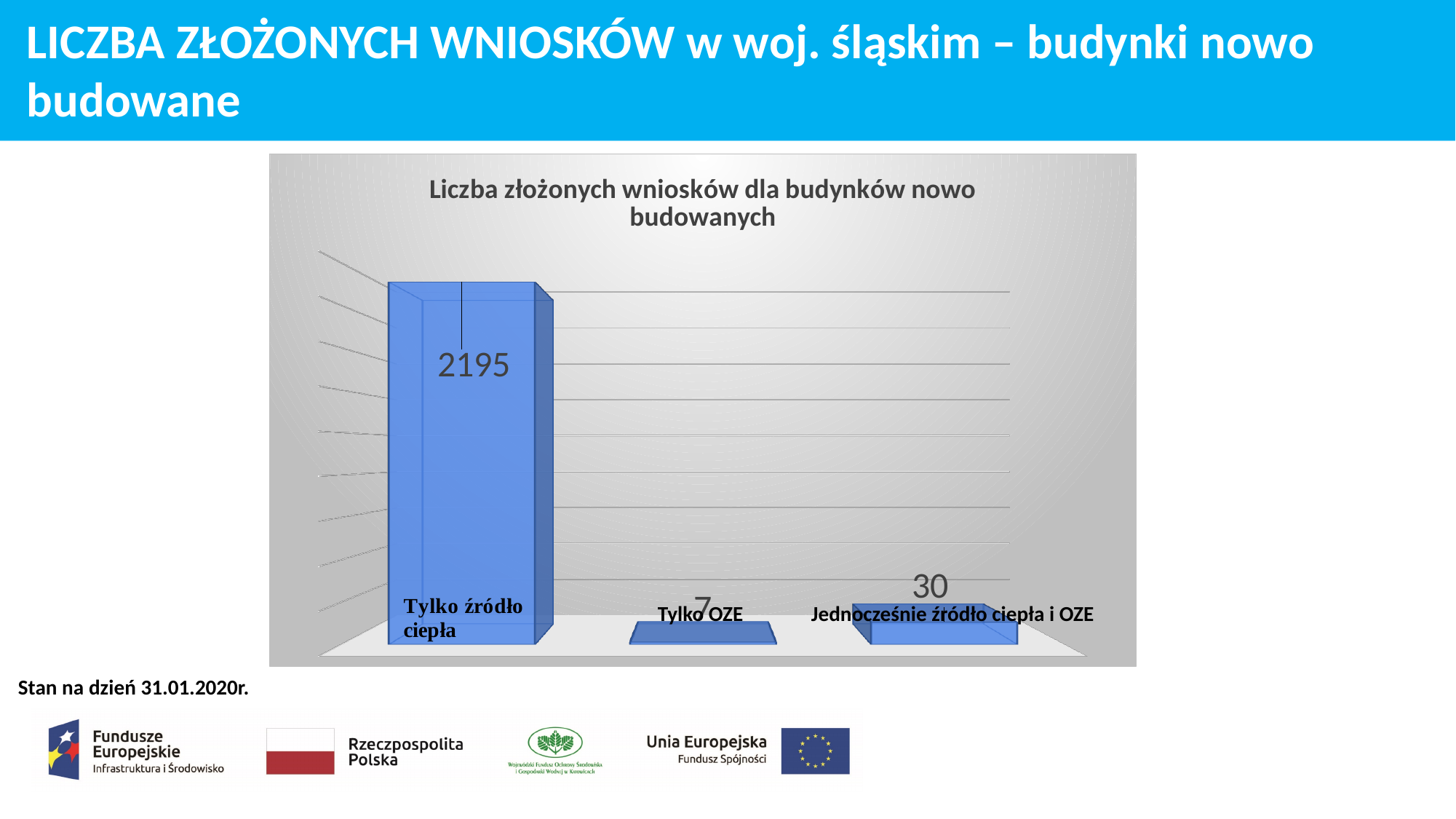
How many categories are shown in the chart? 3 Which category has the highest value? Tylko źródło ciepła What is the difference between the values for "Tylko źródło ciepła" and "Jednocześnie źródło ciepła i OZE"? 2165 What kind of chart is shown on the slide? Bar chart What is the difference between the values for "Jednocześnie źródło ciepła i OZE" and "Tylko OZE"? 23 What is the title of the chart? Liczba złożonych wniosków dla budynków nowo budowanych Which category has the lowest value? Tylko OZE What is the value for "Tylko OZE"? 7 What is the value for "Jednocześnie źródło ciepła i OZE"? 30 Which is larger, the value for "Tylko OZE" or for "Jednocześnie źródło ciepła i OZE"? Jednocześnie źródło ciepła i OZE What is the value for "Tylko źródło ciepła"? 2195 What is the total of the three values shown in the chart? 2232